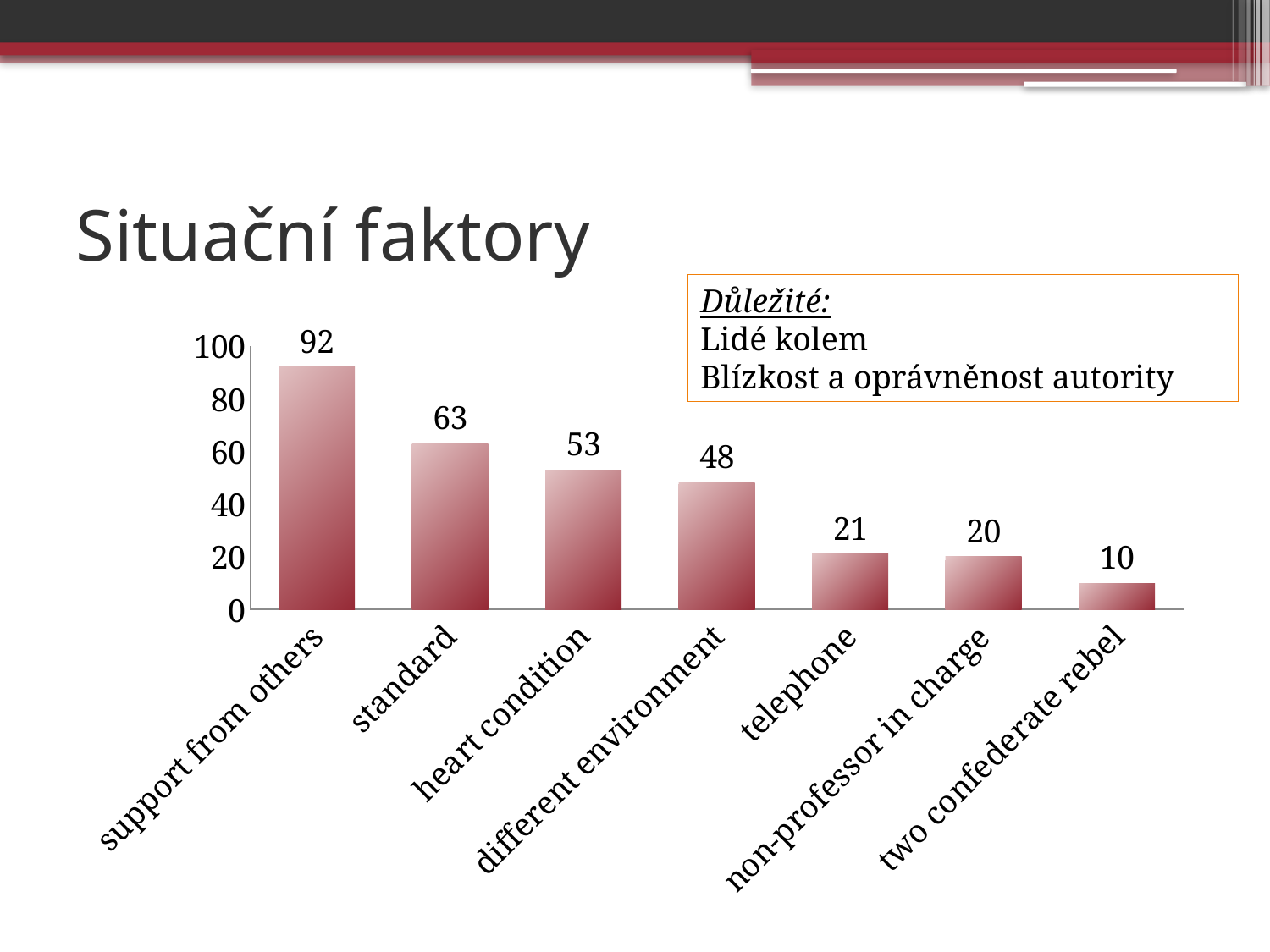
Is the value for different environment greater or less than 40? greater Do the values rise or fall from left to right along the x axis? fall What is the value for heart condition? 53 What is the value for non-professor in charge? 20 What kind of chart is shown on the slide? bar chart What is the title of the slide containing the chart? Situační faktory Which category has the highest value? support from others Which is larger, the value for telephone or the value for heart condition? heart condition What is the value for support from others? 92 Which category has the lowest value? two confederate rebel What is the difference between the values for standard and different environment? 15 How many categories are shown in the chart? 7